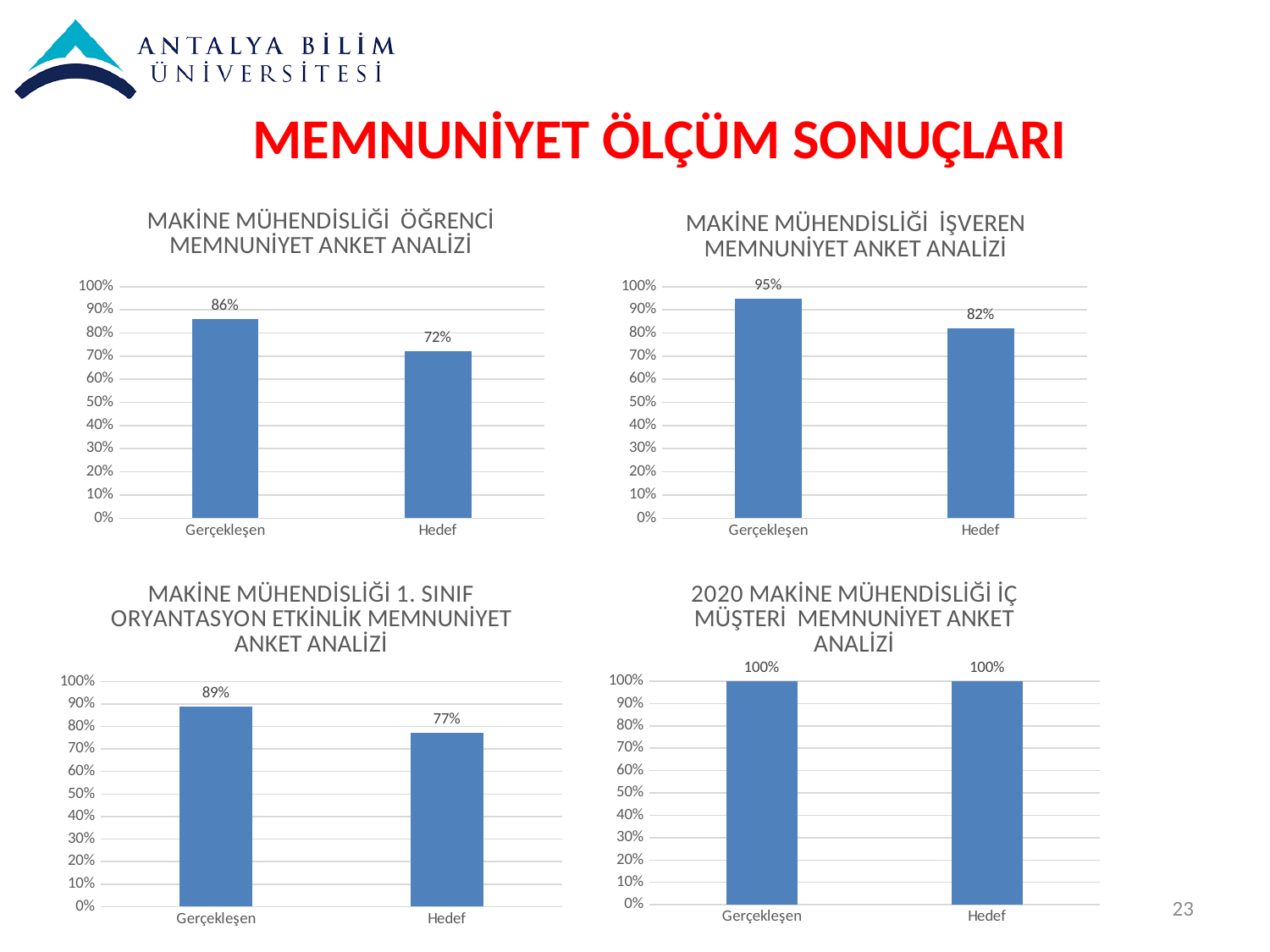
In the top-left chart (MAKİNE MÜHENDİSLİĞİ ÖĞRENCİ MEMNUNİYET ANKET ANALİZİ), what is the value for Gerçekleşen? 86% What kind of chart is the top-right chart (MAKİNE MÜHENDİSLİĞİ İŞVEREN MEMNUNİYET ANKET ANALİZİ)? Bar chart In the top-left chart (MAKİNE MÜHENDİSLİĞİ ÖĞRENCİ MEMNUNİYET ANKET ANALİZİ), what is the value for Hedef? 72% In the bottom-left chart (MAKİNE MÜHENDİSLİĞİ 1. SINIF ORYANTASYON ETKİNLİK MEMNUNİYET ANKET ANALİZİ), which category is highest? Gerçekleşen In the bottom-right chart (2020 MAKİNE MÜHENDİSLİĞİ İÇ MÜŞTERİ MEMNUNİYET ANKET ANALİZİ), what is the difference between Gerçekleşen and Hedef? 0% How many categories does the bottom-left chart (MAKİNE MÜHENDİSLİĞİ 1. SINIF ORYANTASYON ETKİNLİK MEMNUNİYET ANKET ANALİZİ) show? 2 In the top-left chart (MAKİNE MÜHENDİSLİĞİ ÖĞRENCİ MEMNUNİYET ANKET ANALİZİ), which is larger, Gerçekleşen or Hedef? Gerçekleşen In the top-right chart (MAKİNE MÜHENDİSLİĞİ İŞVEREN MEMNUNİYET ANKET ANALİZİ), which category is lowest? Hedef In the top-right chart (MAKİNE MÜHENDİSLİĞİ İŞVEREN MEMNUNİYET ANKET ANALİZİ), what is the value for Gerçekleşen? 95% In the bottom-left chart (MAKİNE MÜHENDİSLİĞİ 1. SINIF ORYANTASYON ETKİNLİK MEMNUNİYET ANKET ANALİZİ), what is the value for Hedef? 77% In the bottom-right chart (2020 MAKİNE MÜHENDİSLİĞİ İÇ MÜŞTERİ MEMNUNİYET ANKET ANALİZİ), what is the value for Gerçekleşen? 100% In the top-right chart (MAKİNE MÜHENDİSLİĞİ İŞVEREN MEMNUNİYET ANKET ANALİZİ), what is the difference between Gerçekleşen and Hedef? 13%